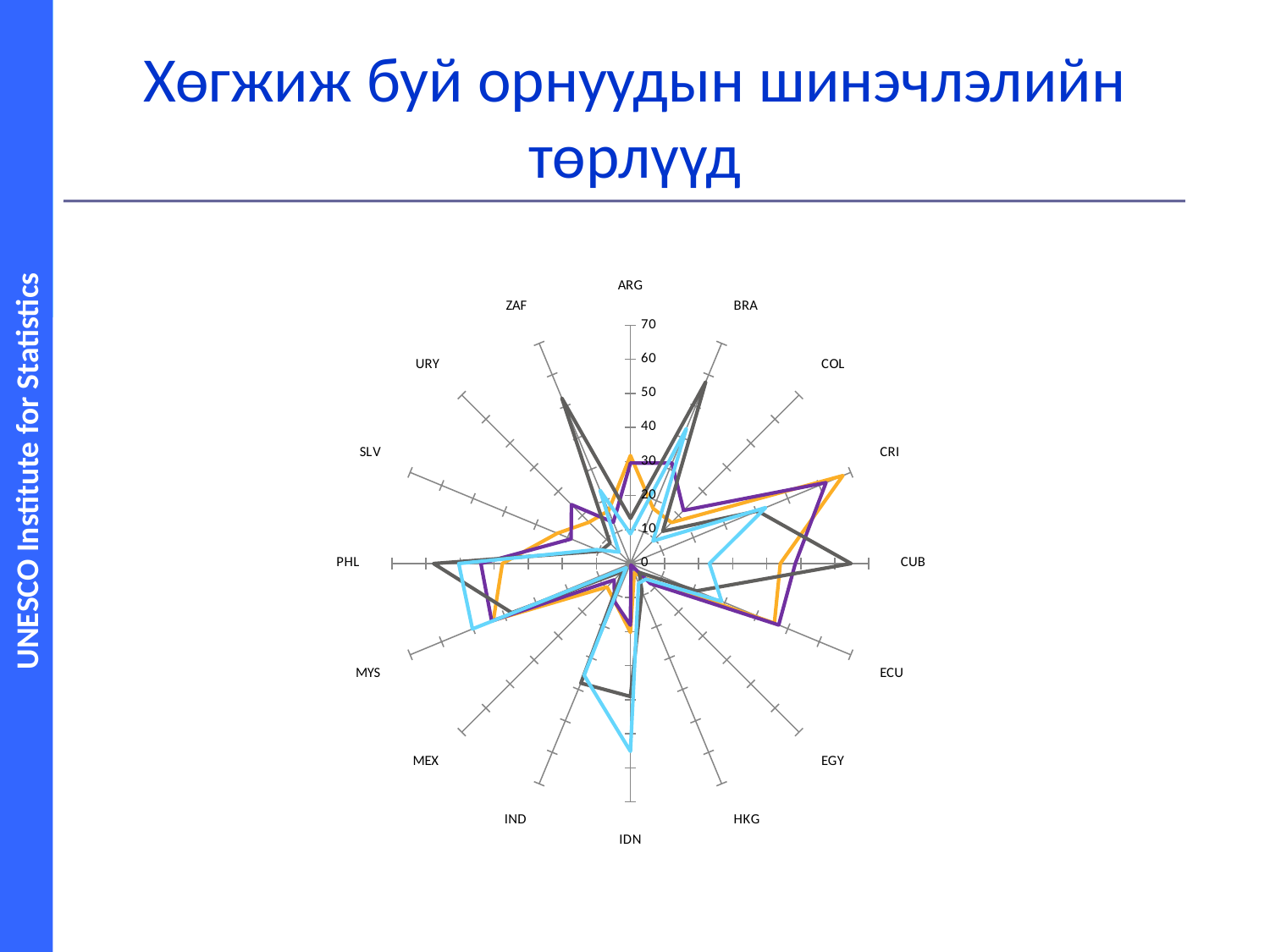
Is the light blue series value for IDN greater or less than 40? greater Is the purple series value for ECU greater or less than 30? greater Is the light blue series value for CUB greater or less than 40? less What is the title of the slide containing the radar chart? Хөгжиж буй орнуудын шинэчлэлийн төрлүүд How many country categories are plotted around the radar chart? 16 What is the maximum value shown on the radar chart's axis scale? 70 What kind of chart is shown on the slide? Radar chart